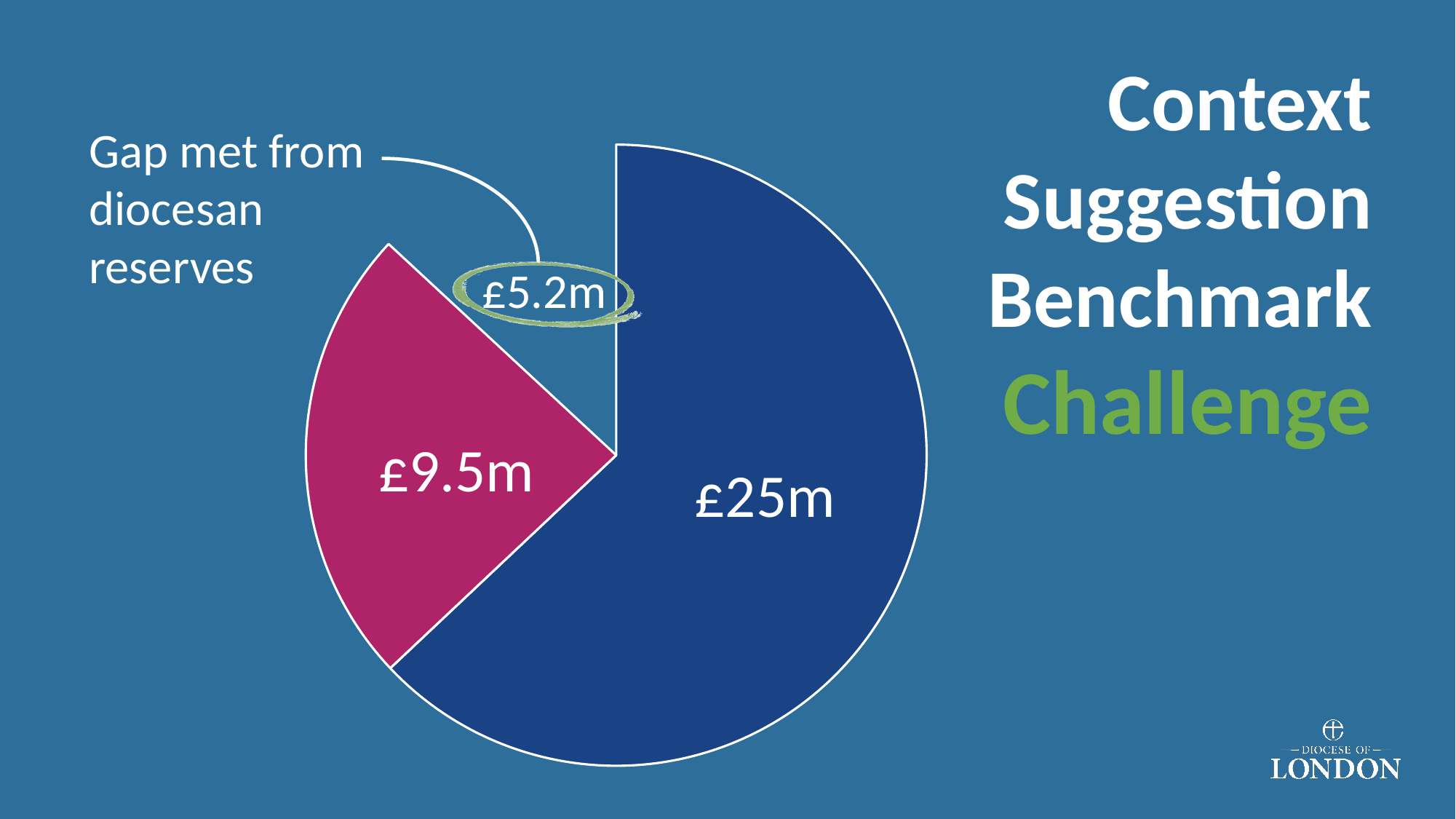
What label is attached to the £5.2m slice? Gap met from diocesan reserves What kind of chart is shown on the slide? Pie chart What is the difference between the £25m slice and the £9.5m slice? £15.5m What value is shown for the slice labelled 'Gap met from diocesan reserves'? £5.2m What is the value of the smallest slice of the pie chart? £5.2m How many slices does the pie chart have? 3 What is the value of the largest slice of the pie chart? £25m What is the value of the magenta slice of the pie chart? £9.5m What is the total of all three slices in the pie chart? £39.7m What colour is the largest slice of the pie chart? Dark blue Which is larger, the dark blue slice or the magenta slice? The dark blue slice (£25m) What is the difference between the £9.5m slice and the £5.2m slice? £4.3m